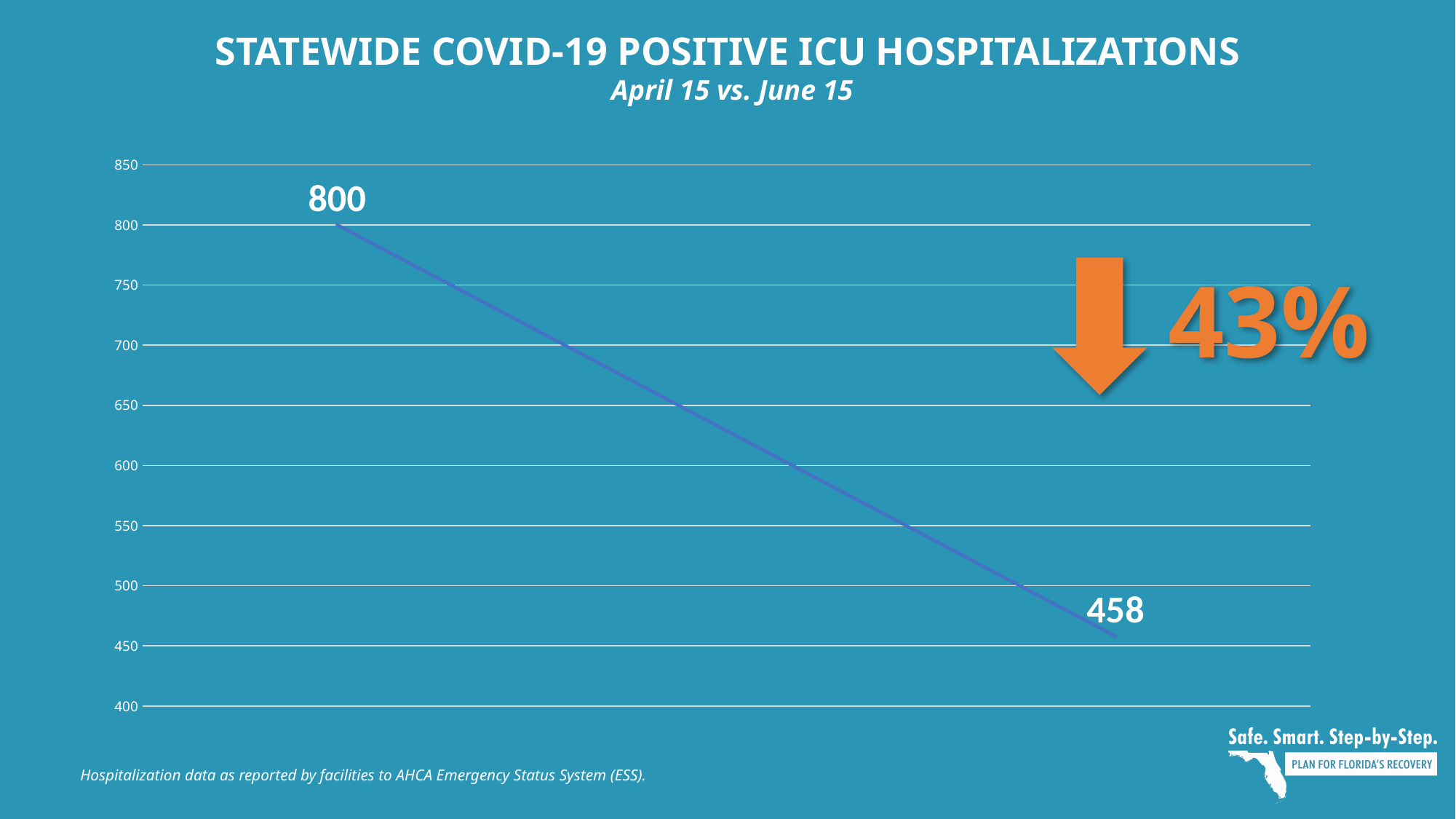
What is the title of the chart? STATEWIDE COVID-19 POSITIVE ICU HOSPITALIZATIONS Which data point has the lowest value? June 15 (458) What is the value of the first data point (April 15) on the line? 800 What percentage decrease is shown next to the orange arrow? 43% What is the difference between the April 15 value and the June 15 value? 342 What type of chart is shown on the slide? line chart How many data points are plotted on the line? 2 Is the June 15 value greater or less than 500? less Which data point has the highest value? April 15 (800) What is the value of the second data point (June 15) on the line? 458 Which is larger, the April 15 value or the June 15 value? April 15 Does the line rise or fall from left to right? fall